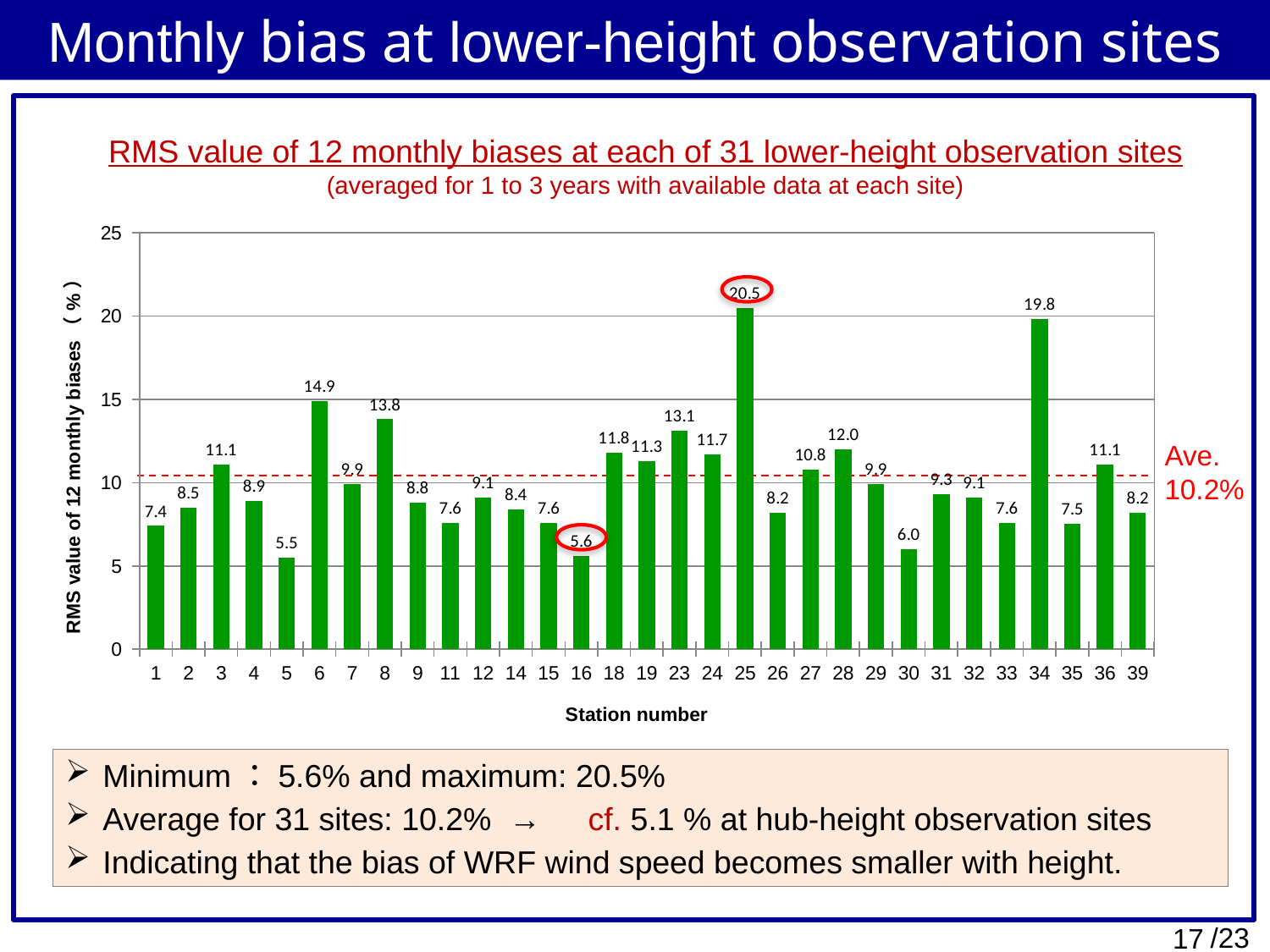
Is the RMS value for station 28 greater or less than 10? greater What is the title of the x axis of the chart? Station number What is the difference between the RMS values for station 25 and station 34? 0.7 What average value is marked by the dashed red line on the chart? 10.2% What is the RMS value of 12 monthly biases for station 30? 6.0 What is the RMS value of 12 monthly biases for station 6? 14.9 Which station number has the highest RMS value of 12 monthly biases? 25 Which has a larger RMS value, station 8 or station 23? Station 8 What kind of chart is used to show the RMS values of monthly biases? Bar chart What is the difference between the RMS values for station 6 and station 8? 1.1 How many stations are shown on the x axis of the chart? 31 What is the RMS value of 12 monthly biases for station 34? 19.8